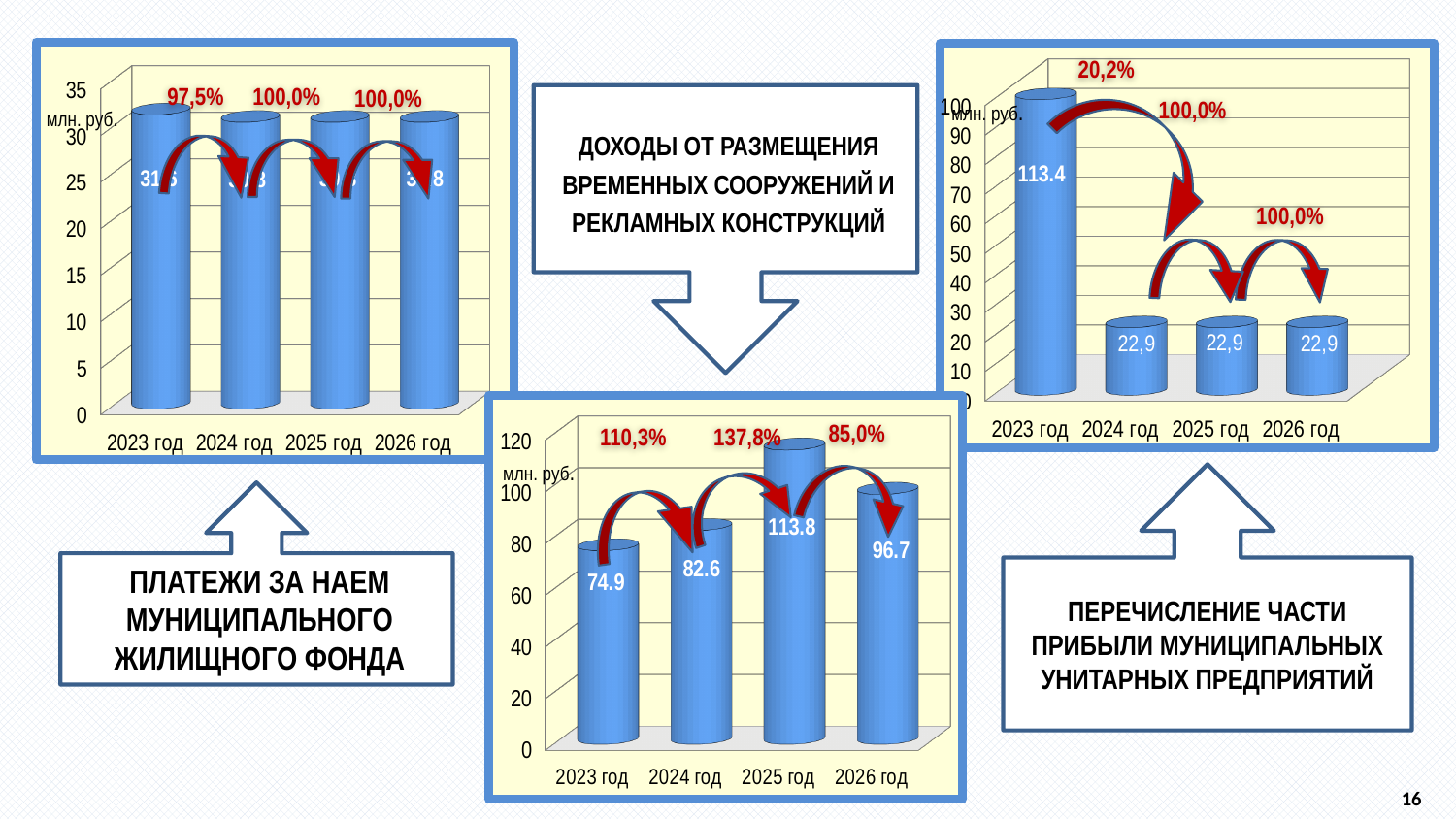
In the bottom-centre chart (Доходы от размещения временных сооружений и рекламных конструкций), which is larger: the value for 2024 год or 2026 год? 2026 год In the chart for 'Доходы от размещения временных сооружений и рекламных конструкций' (bottom centre), what is the value for 2025 год? 113.8 In the bottom-centre chart (Доходы от размещения временных сооружений и рекламных конструкций), do the values rise or fall from 2023 год to 2025 год? rise What kind of chart is the top-left chart (Платежи за наем муниципального жилищного фонда)? bar chart In the bottom-centre chart (Доходы от размещения временных сооружений и рекламных конструкций), what is the difference between the values for 2025 год and 2024 год? 31.2 How many years (categories) are shown in the top-left chart (Платежи за наем муниципального жилищного фонда)? 4 In the right-hand chart (Перечисление части прибыли муниципальных унитарных предприятий), what is the difference between the values for 2023 год and 2024 год? 90.5 In the bottom-centre chart (Доходы от размещения временных сооружений и рекламных конструкций), which year has the highest value? 2025 год In the right-hand chart (Перечисление части прибыли муниципальных унитарных предприятий), what is the value for 2023 год? 113.4 In the right-hand chart (Перечисление части прибыли муниципальных унитарных предприятий), what is the value for 2025 год? 22,9 In the top-left chart (Платежи за наем муниципального жилищного фонда), is the value for 2023 год greater or less than 25? greater In the bottom-centre chart (Доходы от размещения временных сооружений и рекламных конструкций), which year has the lowest value? 2023 год